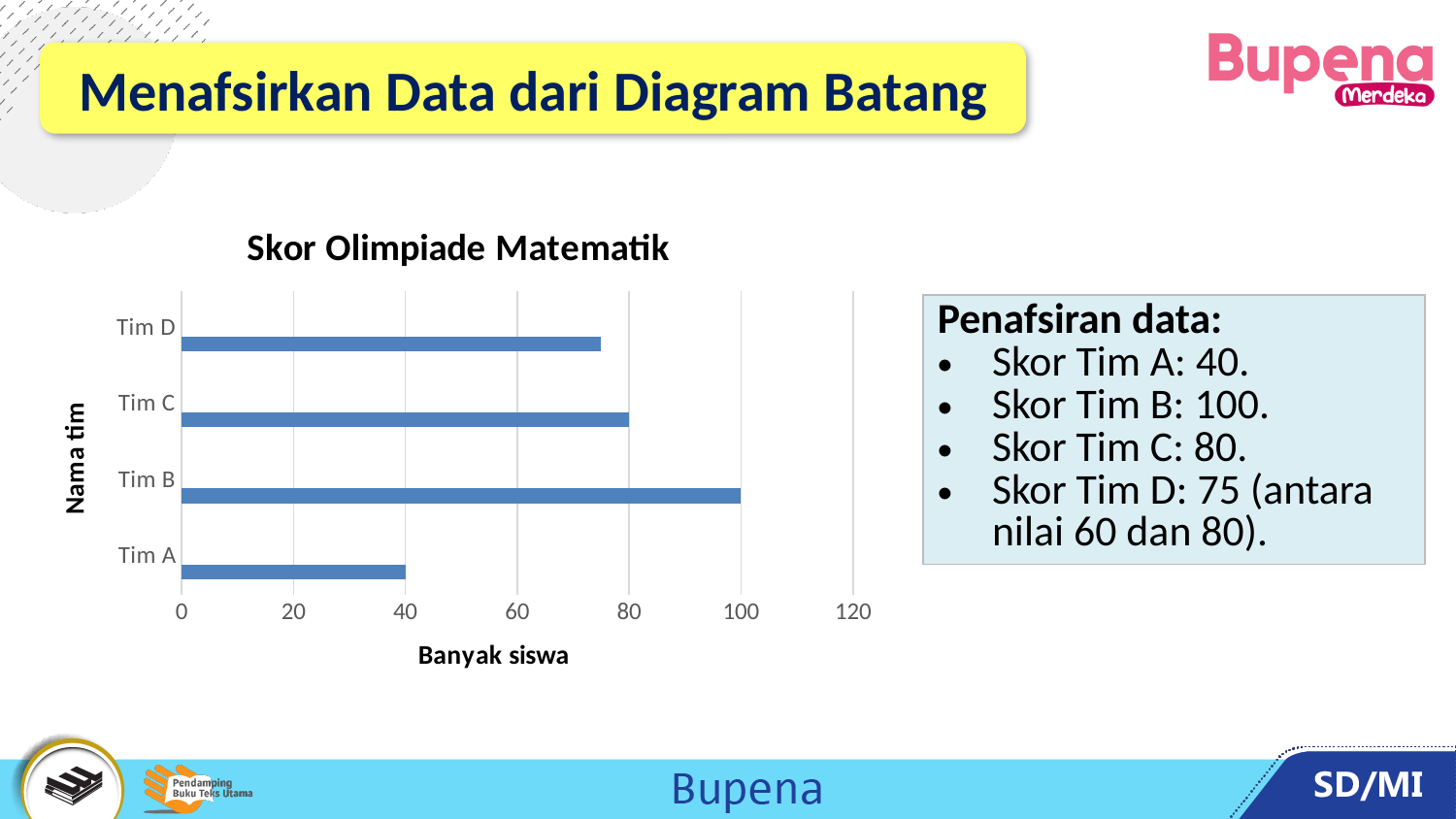
What is the value for Tim A in the chart? 40 What is the value for Tim B in the chart? 100 Is the value for Tim D greater or less than 60? greater What is the difference between the values for Tim B and Tim A? 60 What is the title of the chart? Skor Olimpiade Matematik How many teams are shown in the chart? 4 Which team has the highest value in the chart? Tim B Which team has the lowest value in the chart? Tim A Which is larger, the value for Tim C or the value for Tim D? Tim C What is the difference between the values for Tim C and Tim A? 40 What kind of chart is shown on the slide? bar chart What is the value for Tim C in the chart? 80